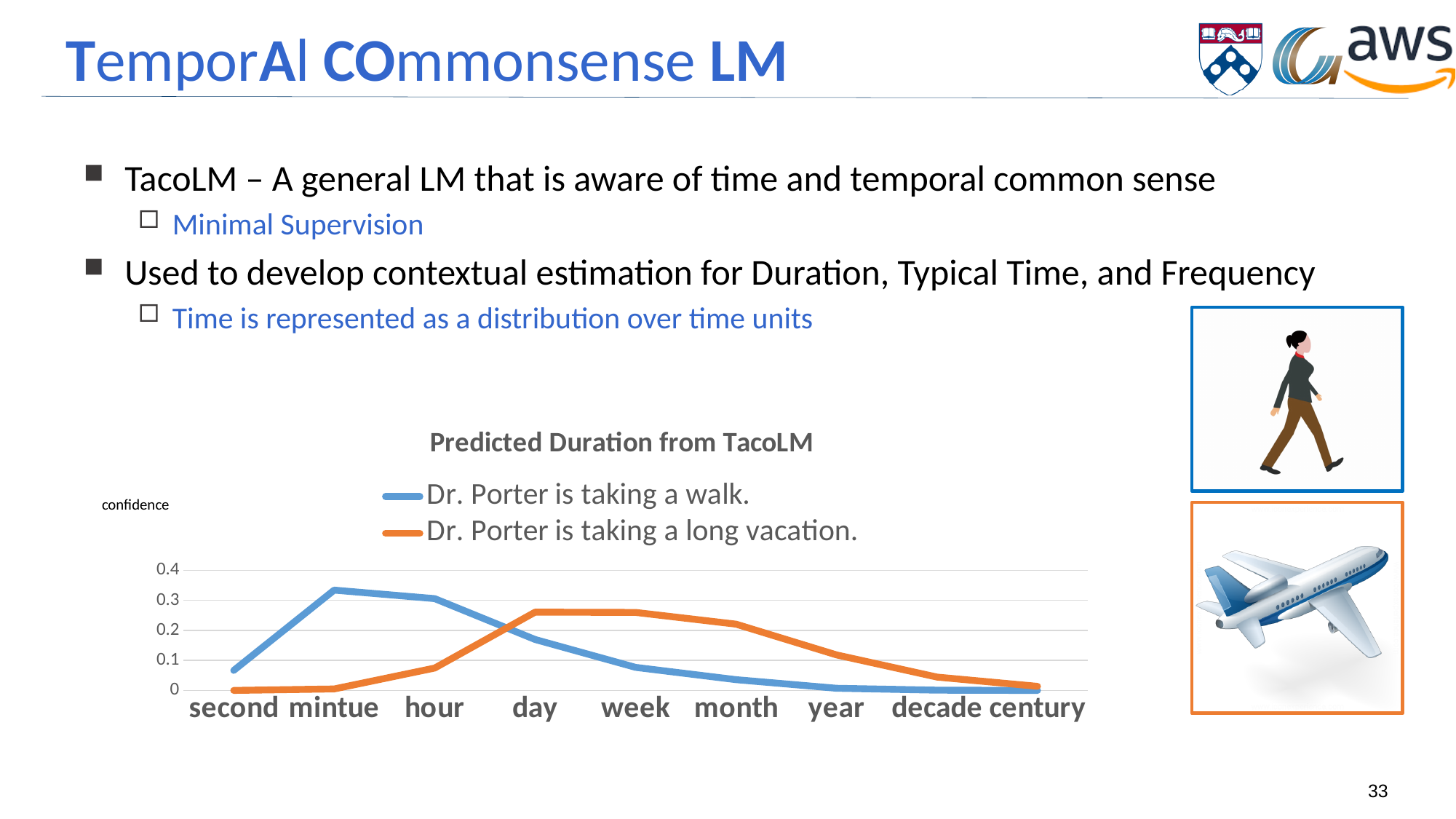
How many series does the chart legend list? 2 How many time-unit categories are shown on the x axis of the chart? 9 Is the confidence for 'Dr. Porter is taking a long vacation.' at 'day' greater or less than 0.2? greater What kind of chart is shown on the slide? line chart At 'month', which series has the higher confidence? Dr. Porter is taking a long vacation. For the series 'Dr. Porter is taking a walk.', which time unit has the highest confidence? mintue Does the confidence for 'Dr. Porter is taking a long vacation.' rise or fall from 'week' to 'century'? fall Is the confidence for 'Dr. Porter is taking a walk.' at 'mintue' greater or less than 0.3? greater Which series is drawn in orange in the chart? Dr. Porter is taking a long vacation. At 'hour', which series has the higher confidence? Dr. Porter is taking a walk. Is the confidence for 'Dr. Porter is taking a walk.' at 'week' greater or less than 0.1? less What is the title of the chart? Predicted Duration from TacoLM